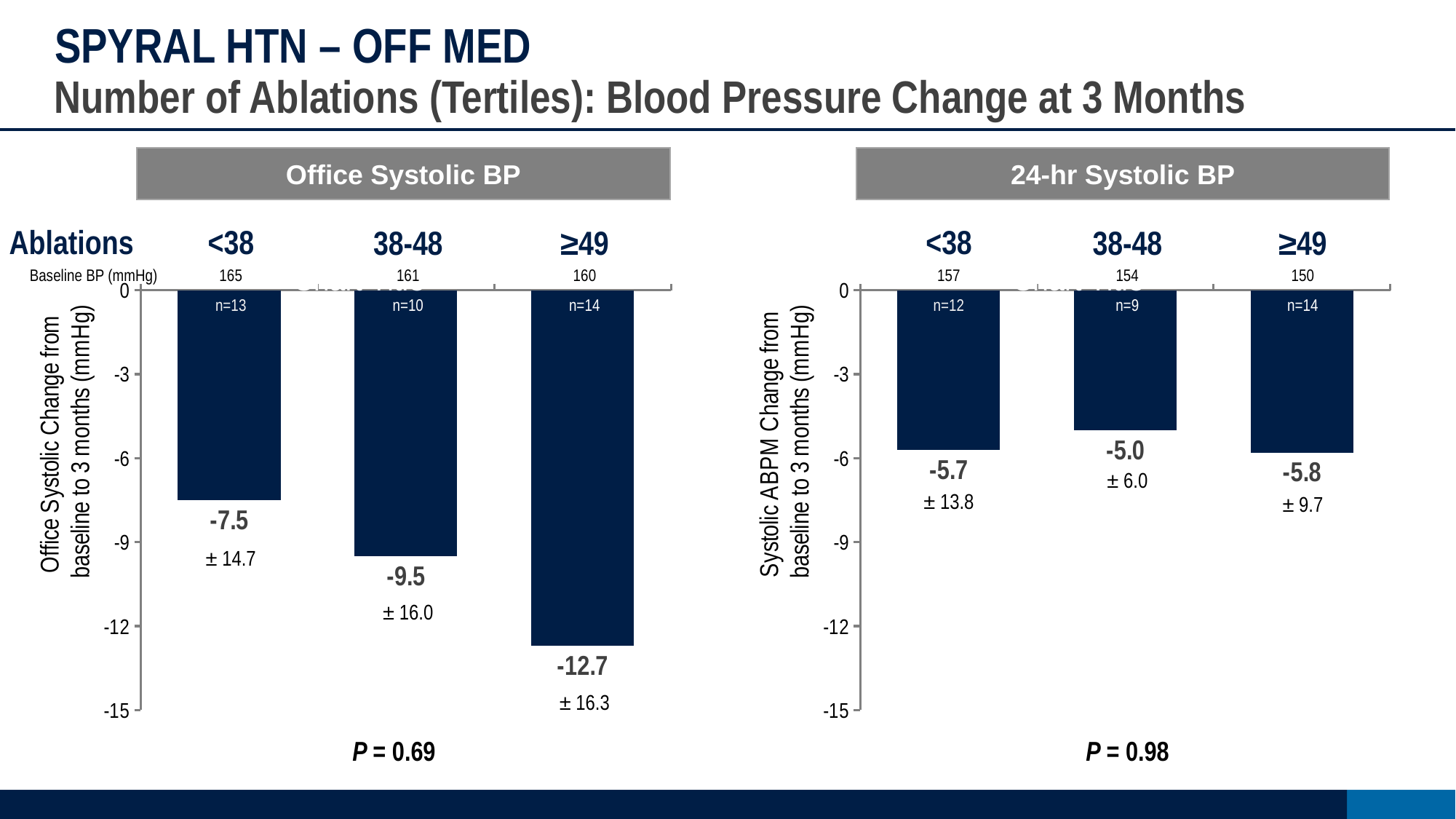
In the Office Systolic BP chart, what is the change from baseline for the ≥49 ablations group? -12.7 In the Office Systolic BP chart, which ablation group shows the largest reduction in blood pressure? ≥49 In the Office Systolic BP chart, what is the change from baseline for the <38 ablations group? -7.5 In the 24-hr Systolic BP chart, what is the change from baseline for the ≥49 ablations group? -5.8 In the Office Systolic BP chart, how many ablation groups are plotted? 3 In the 24-hr Systolic BP chart, which ablation group shows the smallest reduction in blood pressure? 38-48 In the Office Systolic BP chart, do the blood pressure reductions get larger or smaller as the number of ablations increases? Larger What is the P value shown under the 24-hr Systolic BP chart? P = 0.98 In the Office Systolic BP chart, which ablation group shows the smallest reduction in blood pressure? <38 In the Office Systolic BP chart, what is the difference between the change for the ≥49 group and the <38 group? 5.2 In the 24-hr Systolic BP chart, what is the change from baseline for the 38-48 ablations group? -5.0 What type of chart is used for the 24-hr Systolic BP data? Bar chart